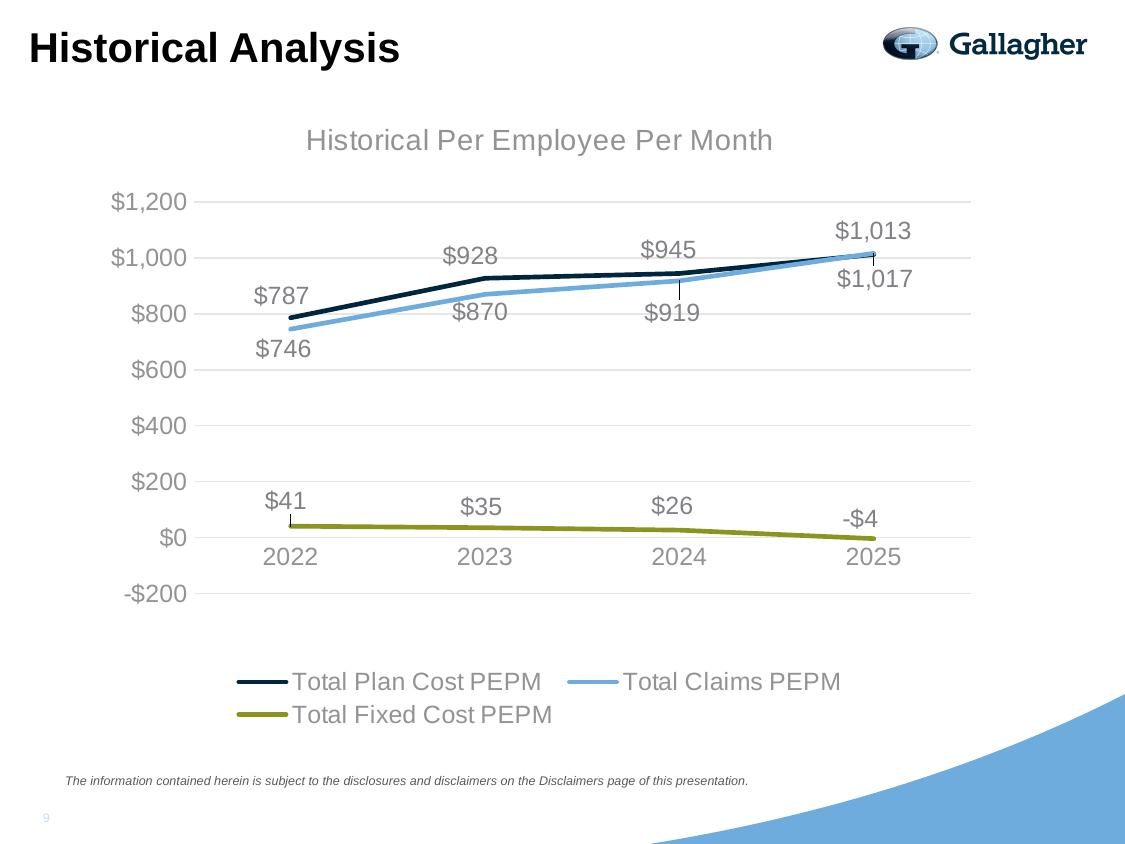
What kind of chart is shown on the slide? line chart What is the Total Claims PEPM value for 2022? $746 What is the difference between Total Plan Cost PEPM and Total Claims PEPM in 2024? $26 How many series does the legend list? 3 What is the Total Fixed Cost PEPM value for 2025? -$4 Which is larger in 2022, Total Plan Cost PEPM or Total Claims PEPM? Total Plan Cost PEPM How many years are plotted on the x axis? 4 What is the Total Plan Cost PEPM value for 2023? $928 What is the title of the chart? Historical Per Employee Per Month Does Total Claims PEPM rise or fall from 2022 to 2025? rise In which year is Total Fixed Cost PEPM lowest? 2025 In which year is Total Plan Cost PEPM highest? 2025